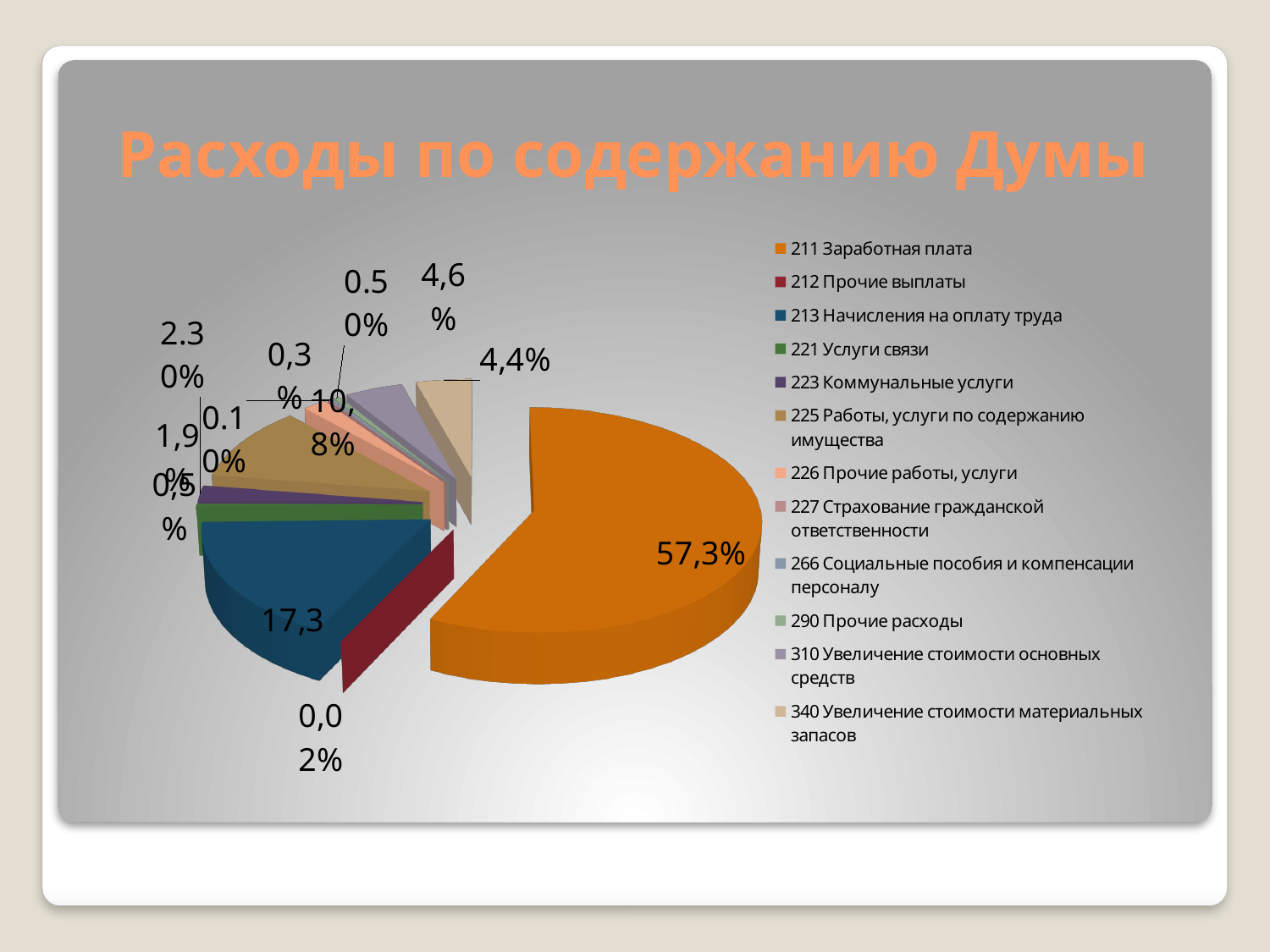
Which is larger, the share for 213 Начисления на оплату труда or for 225 Работы, услуги по содержанию имущества? 213 Начисления на оплату труда What kind of chart is shown on the slide? pie chart Which category has the largest share of the pie? 211 Заработная плата Which is larger, the share for 211 Заработная плата or for 213 Начисления на оплату труда? 211 Заработная плата What is the difference between the shares of 211 Заработная плата and 213 Начисления на оплату труда? 40,0% What is the value shown for 225 Работы, услуги по содержанию имущества? 10,8% What is the value shown for 340 Увеличение стоимости материальных запасов? 4,4% What colour represents 211 Заработная плата in the chart? orange What is the value shown for 213 Начисления на оплату труда? 17,3% What share of the pie does 211 Заработная плата have? 57,3% What is the title of the chart? Расходы по содержанию Думы How many categories does the legend list? 12